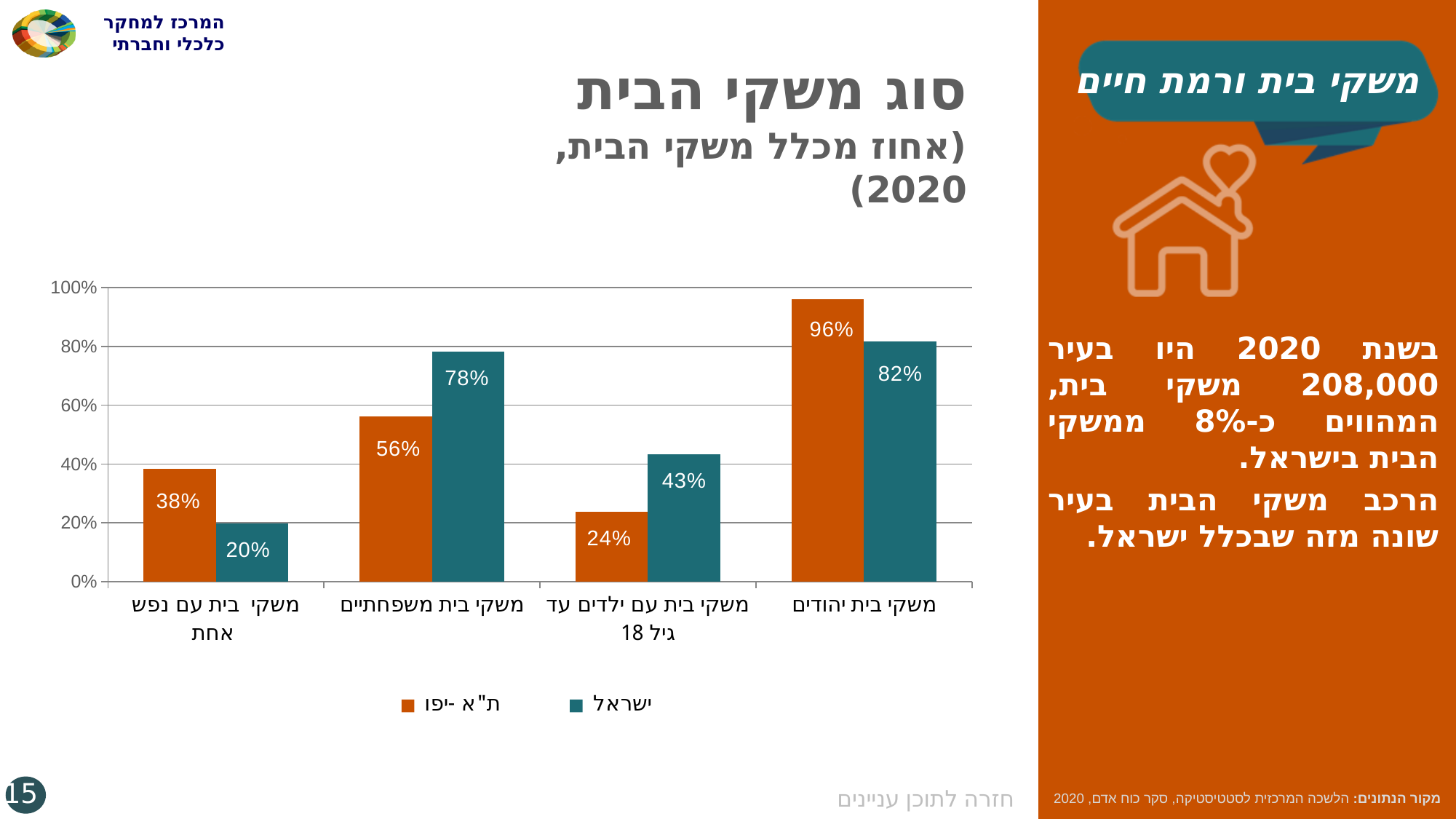
What kind of chart is shown on the slide? bar chart What is the value for ישראל in the category משקי בית עם ילדים עד גיל 18? 43% How many series does the chart legend list? 2 What is the value for ת"א -יפו in the category משקי בית עם נפש אחת? 38% What is the value for ת"א -יפו in the category משקי בית יהודים? 96% How many categories are shown on the x axis of the chart? 4 Which colour represents ישראל in the chart? teal In the category משקי בית עם ילדים עד גיל 18, which is larger: ת"א -יפו or ישראל? ישראל What is the difference between ישראל and ת"א -יפו in the category משקי בית משפחתיים? 22% What is the value for ישראל in the category משקי בית משפחתיים? 78% Which category has the highest value for ת"א -יפו? משקי בית יהודים Which category has the lowest value for ישראל? משקי בית עם נפש אחת